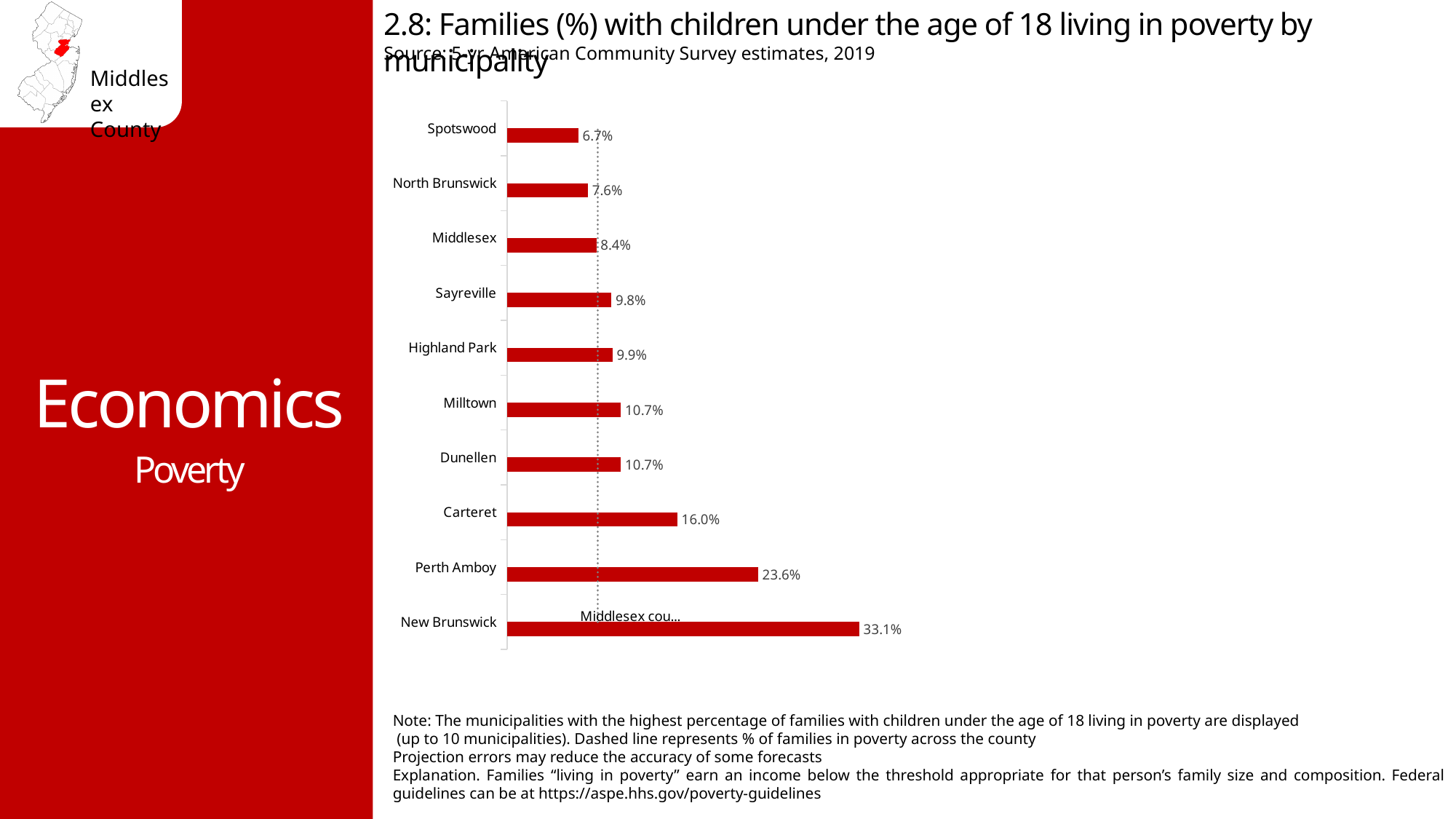
Which municipality has the lowest percentage of families with children under 18 living in poverty? Spotswood Which has a larger value, Carteret or Sayreville? Carteret What is the value for New Brunswick? 33.1% What is the difference between the values for New Brunswick and Perth Amboy? 9.5% What is the value for Carteret? 16.0% Which municipality has the highest percentage of families with children under 18 living in poverty? New Brunswick What is the value for Middlesex? 8.4% What is the value for Spotswood? 6.7% What does the dashed vertical line in the chart represent? % of families in poverty across the county How many municipalities are shown in the chart? 10 What kind of chart is shown on the slide? Bar chart What is the value for Perth Amboy? 23.6%